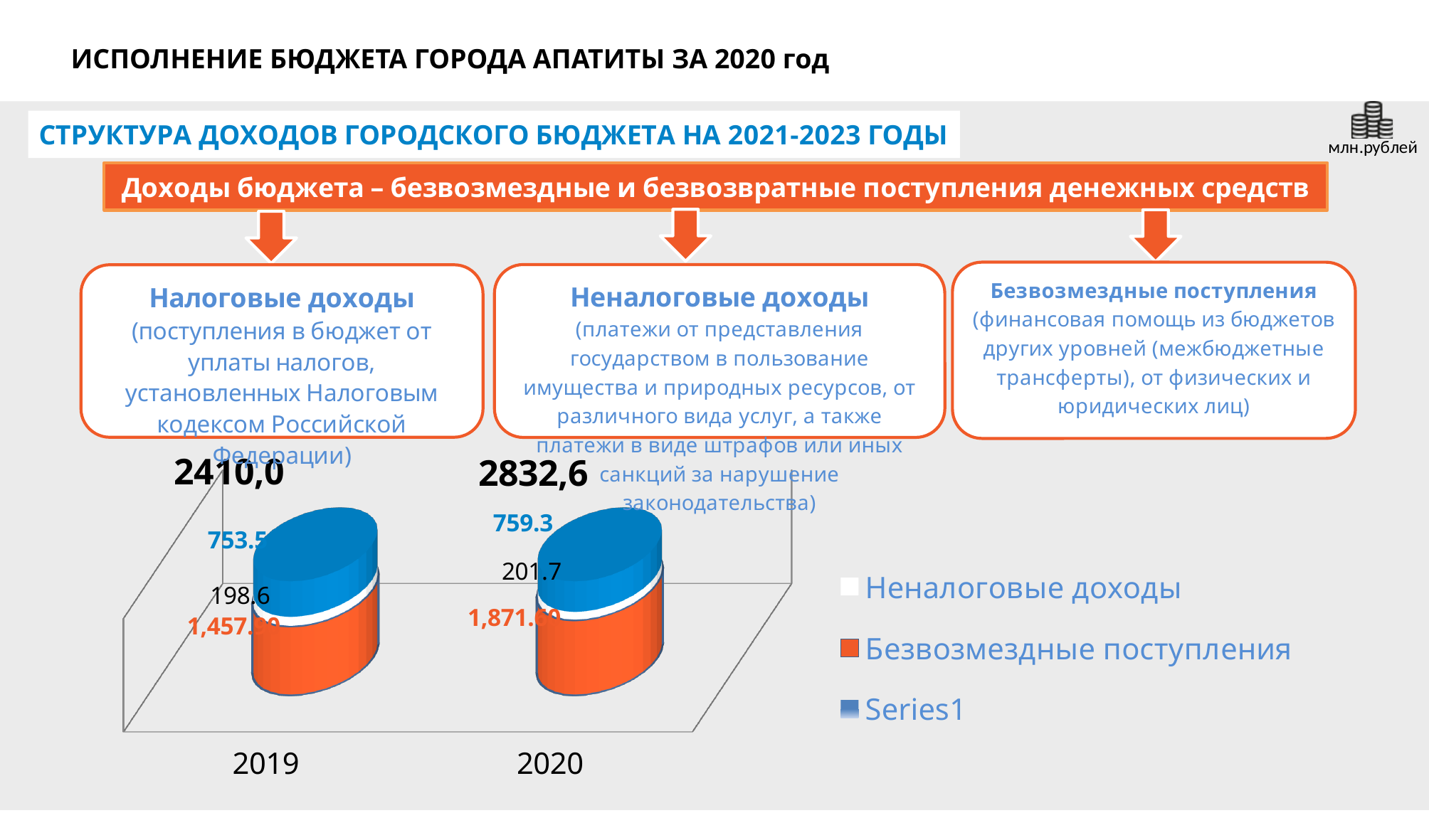
By how much does the 2020 total exceed the 2019 total? 422,6 Do the bar totals rise or fall from 2019 to 2020? rise What is the value of Series1 for 2020? 759.3 What is the value of Неналоговые доходы for 2019? 198,6 What colour represents Безвозмездные поступления in the chart legend? orange What is the value of Неналоговые доходы for 2020? 201.7 What is the total value shown above the 2020 bar? 2832,6 How many categories (years) are shown on the x axis of the chart? 2 What kind of chart is shown at the bottom of the slide? bar chart How many series does the chart legend list? 3 What is the total value shown above the 2019 bar? 2410,0 Which year has the larger total, 2019 or 2020? 2020